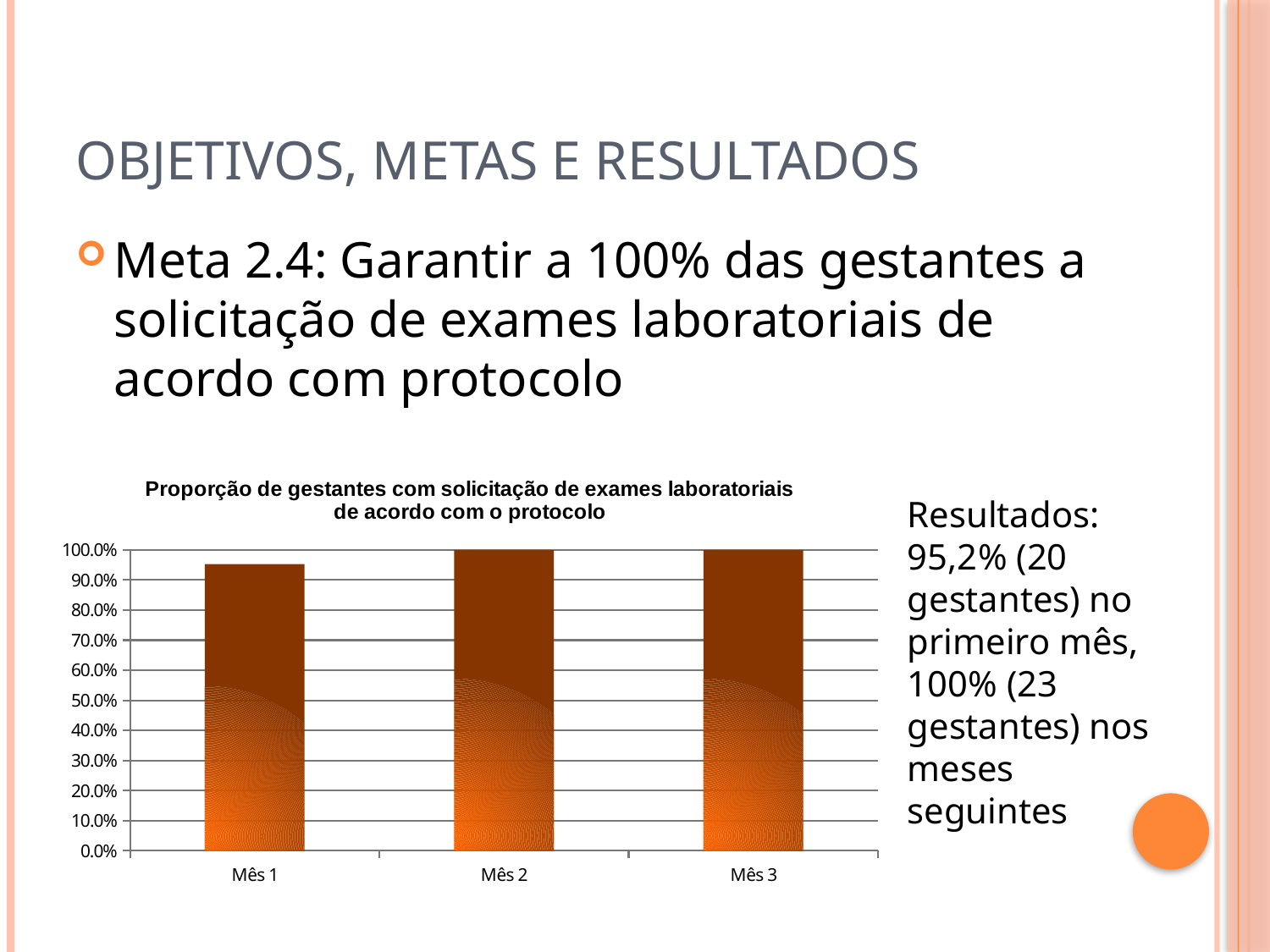
Is the value for Mês 1 greater or less than 90.0%? greater What kind of chart is shown on the slide? bar chart What is the title of the chart? Proporção de gestantes com solicitação de exames laboratoriais de acordo com o protocolo Which month has the lowest value? Mês 1 Which is larger, the value for Mês 1 or the value for Mês 2? Mês 2 Do the values rise or fall from Mês 1 to Mês 2? rise What is the value for Mês 3? 100.0% What is the value for Mês 2? 100.0% What is the difference between the values for Mês 2 and Mês 3? 0.0% What is the highest value shown on the vertical axis of the chart? 100.0% Is the value for Mês 1 greater or less than 100.0%? less How many categories (months) are plotted on the chart? 3